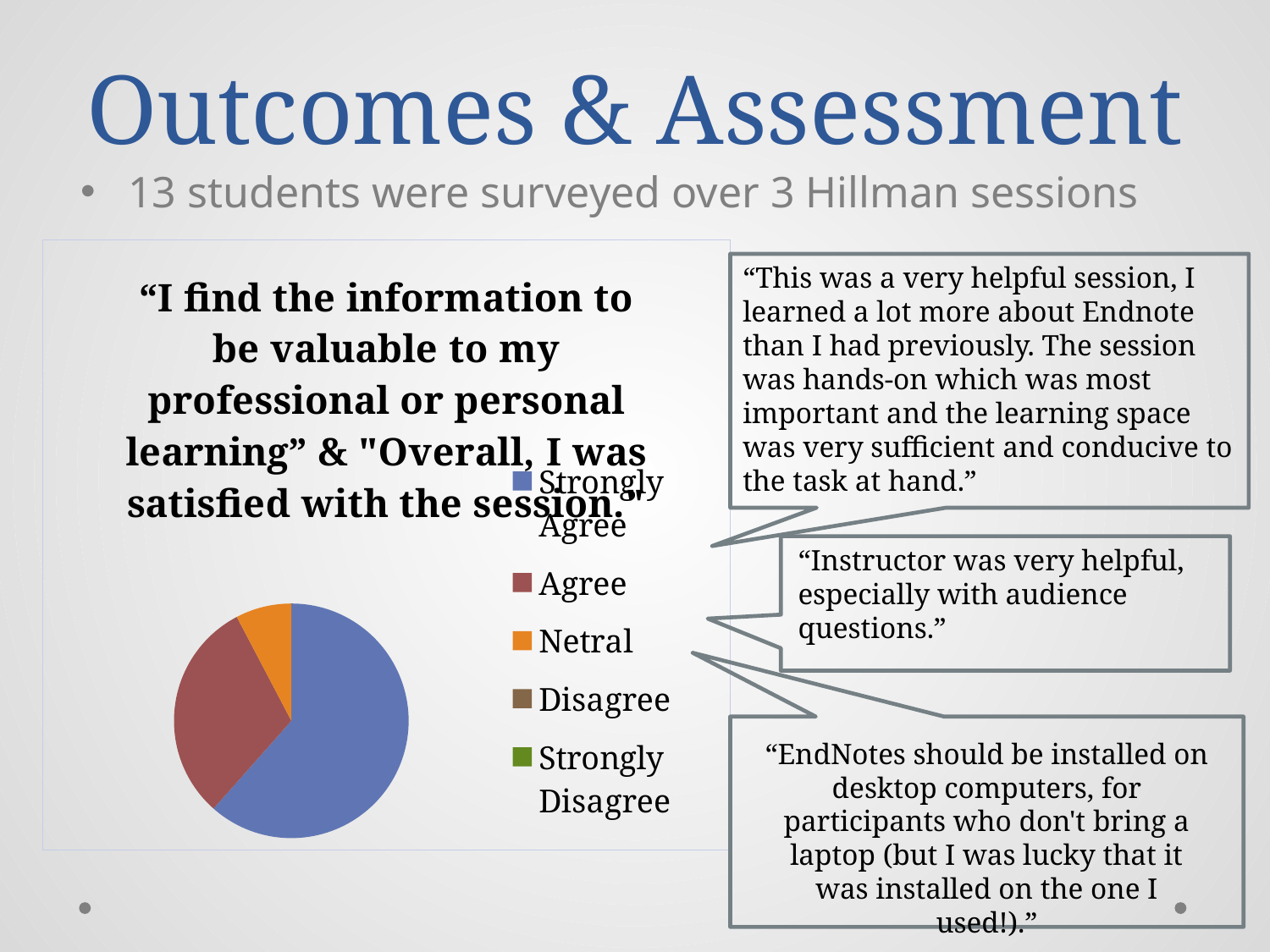
Which response category has the largest slice of the pie chart? Strongly Agree Which is larger in the pie chart, the Strongly Agree slice or the Agree slice? Strongly Agree Which is larger in the pie chart, the Agree slice or the Netral slice? Agree Of the three visible slices in the pie chart, which response category has the smallest slice? Netral How many entries does the legend of the pie chart list? 5 What kind of chart is shown on the slide? pie chart Which legend entry in the pie chart is shown in orange? Netral How many slices are visible in the pie chart? 3 What colour is the Strongly Agree slice in the pie chart? blue